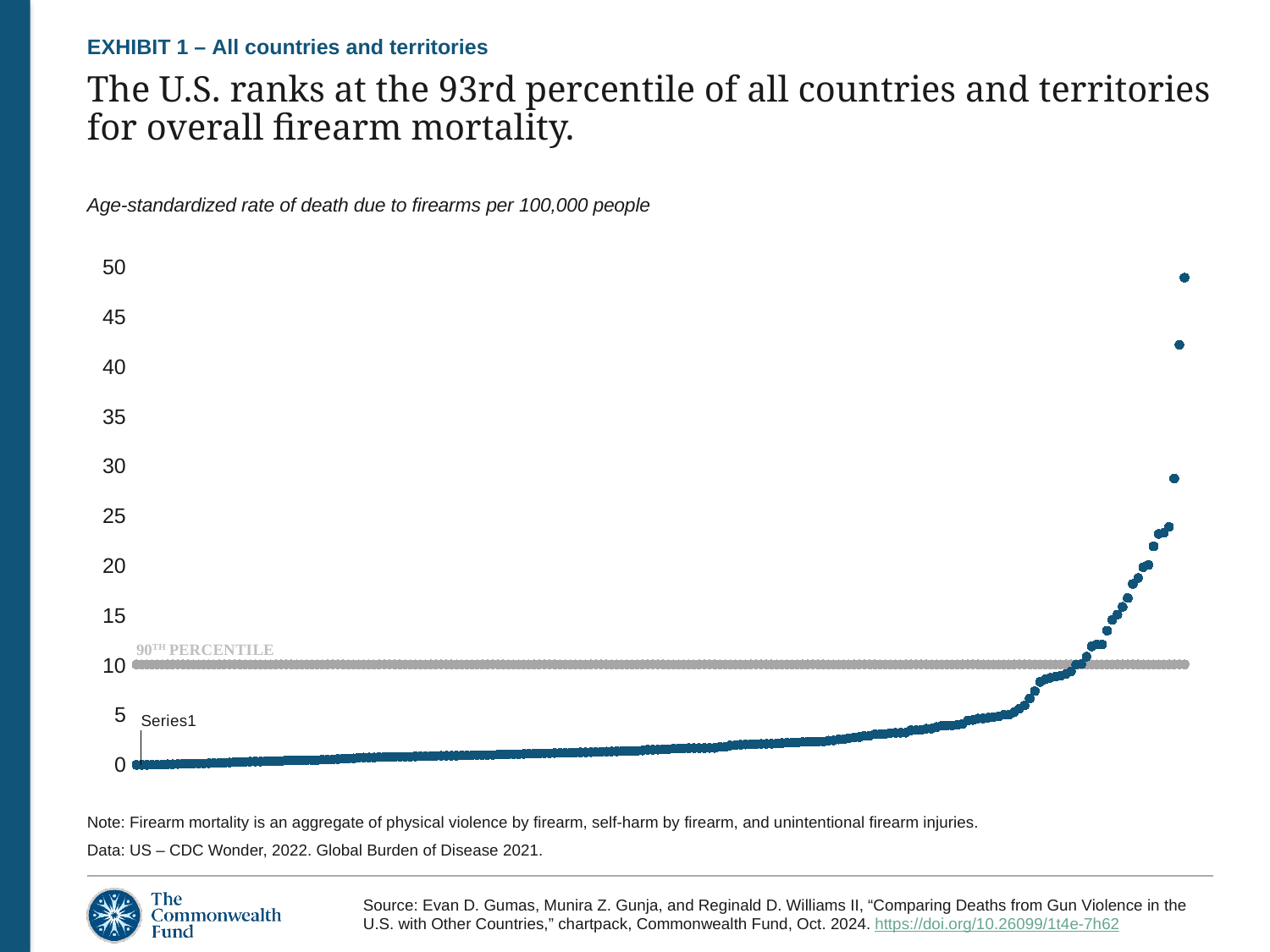
What kind of chart is shown on the slide? Scatter chart Is the third-highest plotted point greater or less than 25? greater Is the highest plotted point greater or less than 45? greater Is the second-highest plotted point greater or less than 40? greater What measure does the chart plot, according to the subtitle? Age-standardized rate of death due to firearms per 100,000 people Do the plotted values rise or fall from left to right along the x axis? Rise What is the highest value shown on the y axis? 50